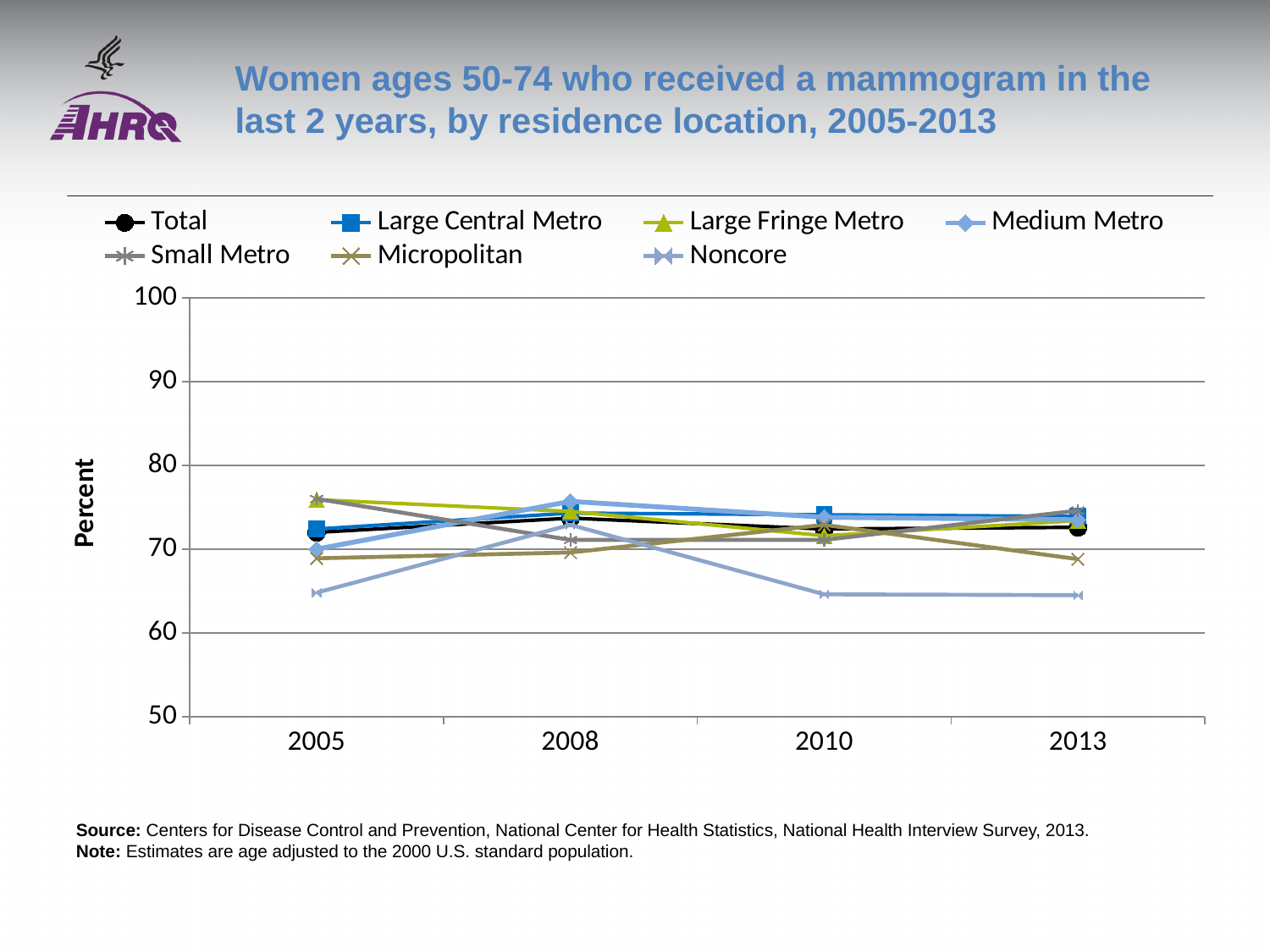
In 2013, which is higher: Total or Noncore? Total How many series does the legend list? 7 What kind of chart is shown on the slide? line chart Which residence location has the lowest value in 2005? Noncore Is the value for Large Fringe Metro in 2005 greater or less than 80? less Does the Large Fringe Metro line rise or fall from 2005 to 2010? fall How many years are plotted along the x axis? 4 Which residence location has the lowest value in 2013? Noncore Is the value for Noncore in 2010 greater or less than 70? less Is the value for Medium Metro in 2008 greater or less than 70? greater What is the label on the y axis? Percent